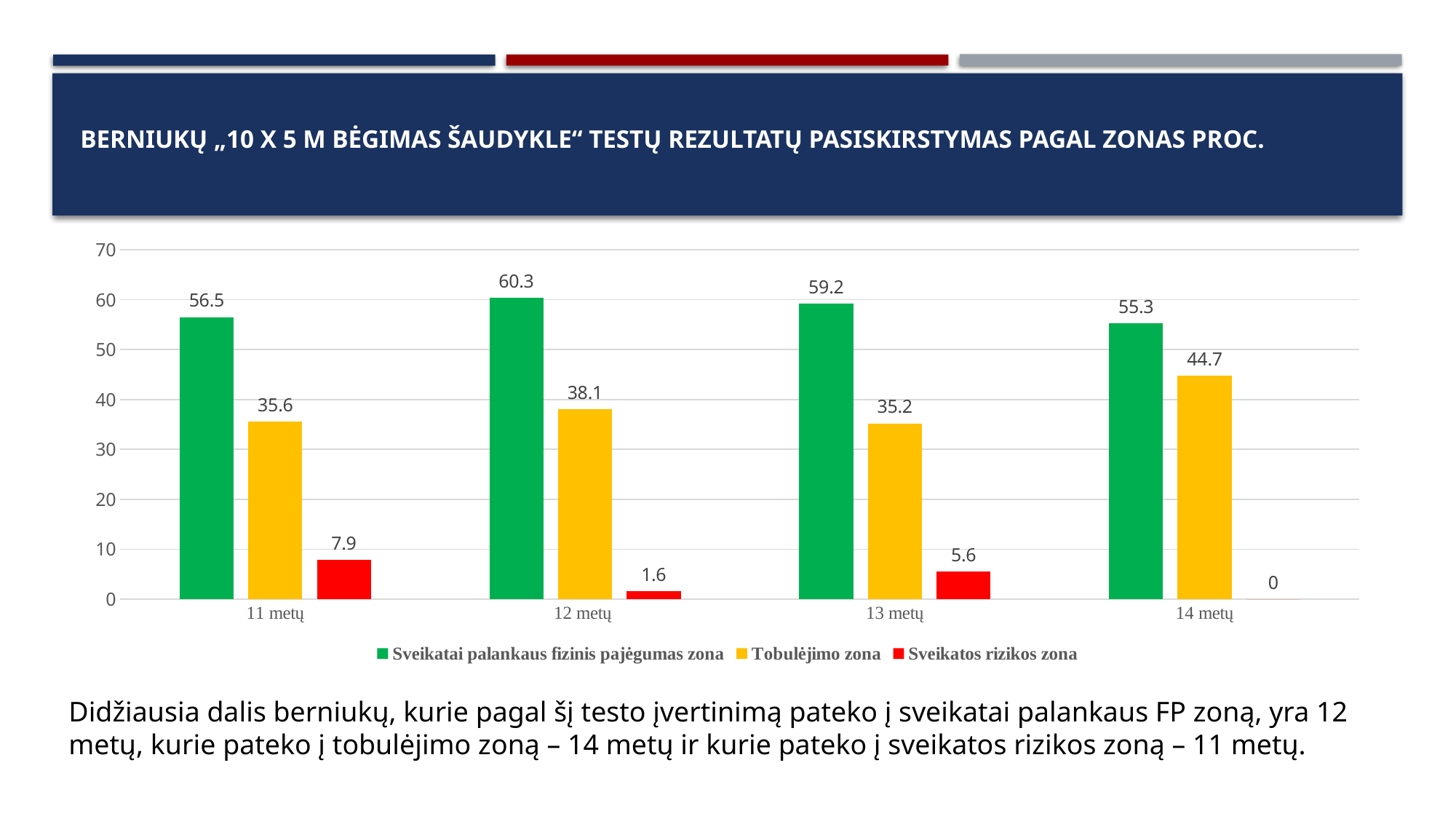
How many age groups are shown on the x axis? 4 Which is larger: the "Sveikatos rizikos zona" value for 11 metų or for 13 metų? 11 metų What is the value for "Sveikatos rizikos zona" at 11 metų? 7.9 What is the value for "Tobulėjimo zona" at 14 metų? 44.7 Is the value for "Tobulėjimo zona" at 12 metų greater or less than 40? less What is the difference between the "Tobulėjimo zona" values for 14 metų and 13 metų? 9.5 What kind of chart is shown on the slide? bar chart What colour are the bars for "Sveikatos rizikos zona"? red What is the value for "Sveikatai palankaus fizinis pajėgumas zona" at 12 metų? 60.3 Which age group has the lowest value for "Sveikatos rizikos zona"? 14 metų Which age group has the highest value for "Sveikatai palankaus fizinis pajėgumas zona"? 12 metų How many series does the legend list? 3